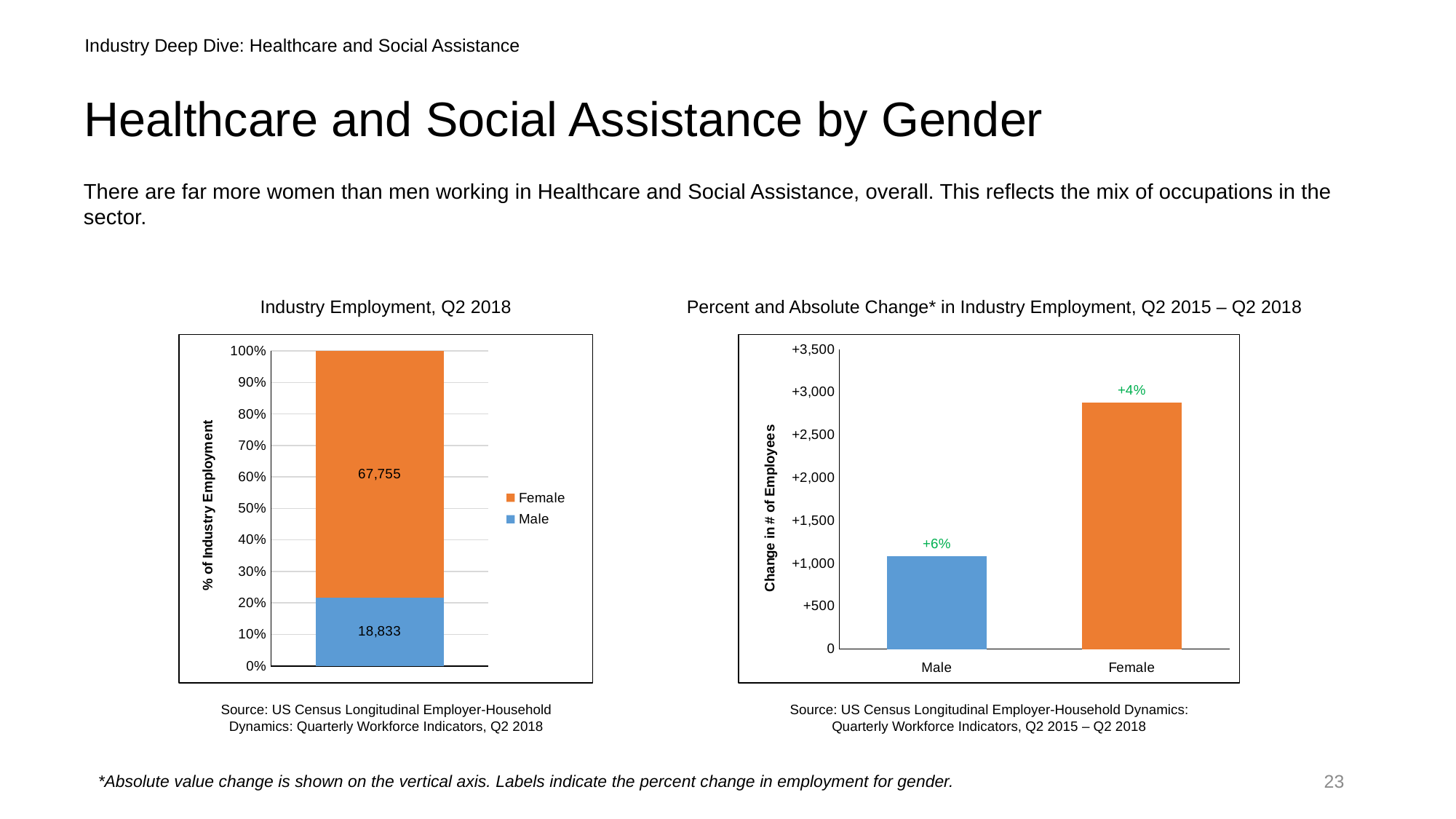
In the 'Industry Employment, Q2 2018' chart, what is the value shown for Female? 67,755 In the 'Percent and Absolute Change in Industry Employment, Q2 2015 – Q2 2018' chart, what percent change label is shown for Female? +4% In the 'Percent and Absolute Change in Industry Employment, Q2 2015 – Q2 2018' chart, is the change in number of employees for Male greater or less than +1,500? less What kind of chart is the 'Industry Employment, Q2 2018' chart? Stacked bar chart In the 'Industry Employment, Q2 2018' chart, what is the difference between the Female and Male values? 48,922 In the 'Industry Employment, Q2 2018' chart, what is the total of the stacked bar? 86,588 How many series does the legend of the 'Industry Employment, Q2 2018' chart list? 2 In the 'Industry Employment, Q2 2018' chart, which series has the larger value, Female or Male? Female In the 'Percent and Absolute Change in Industry Employment, Q2 2015 – Q2 2018' chart, is the change in number of employees for Female greater or less than +2,500? greater In the 'Industry Employment, Q2 2018' chart, what is the value shown for Male? 18,833 In the 'Percent and Absolute Change in Industry Employment, Q2 2015 – Q2 2018' chart, what percent change label is shown for Male? +6% In the 'Percent and Absolute Change in Industry Employment, Q2 2015 – Q2 2018' chart, which category has the higher bar? Female